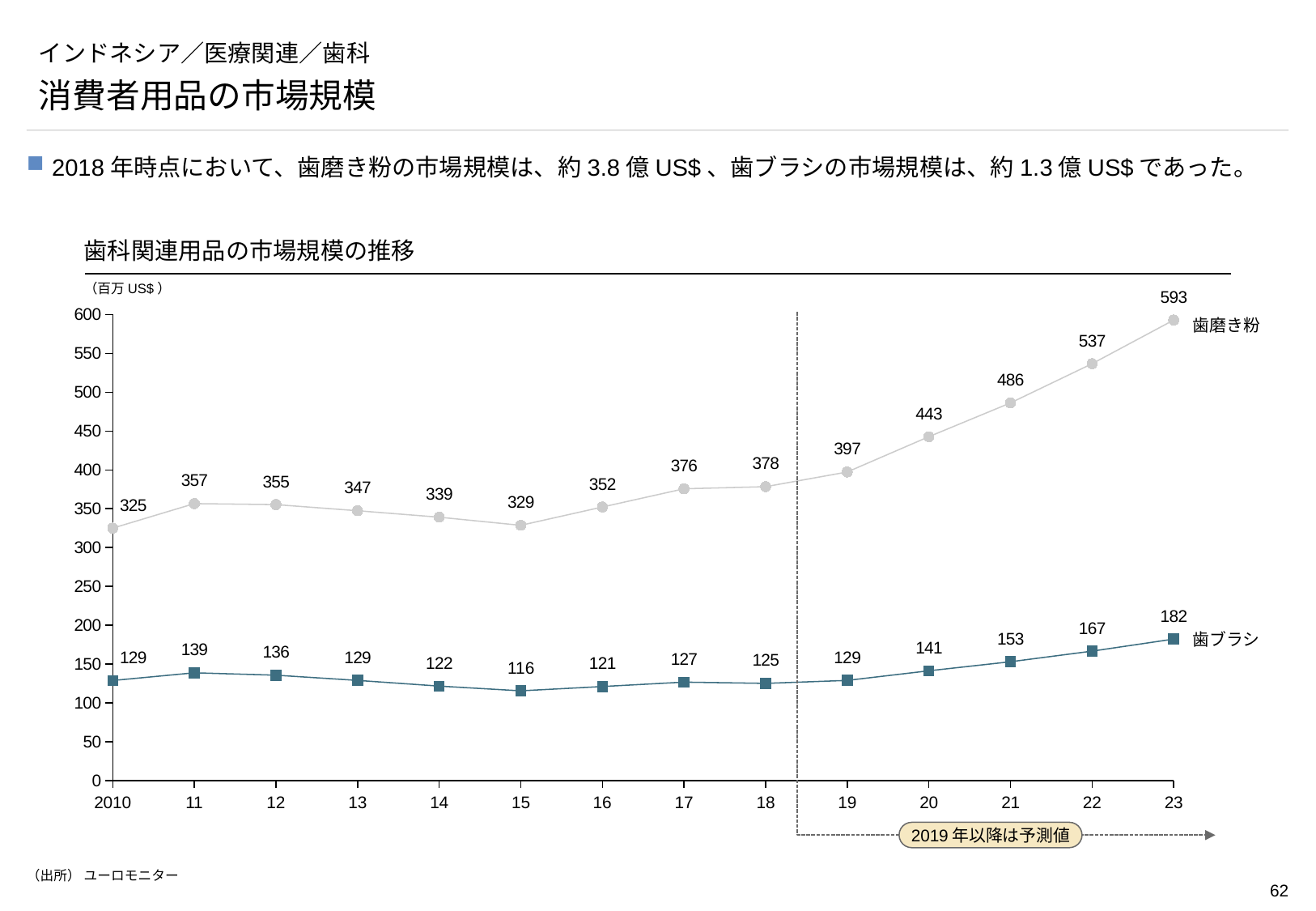
What is the value for 歯磨き粉 in 2018? 378 In which year is the 歯ブラシ series at its highest? 23 How many years are plotted on the x axis? 14 How many series are plotted on the chart? 2 What is the value for 歯ブラシ in 2015? 116 Is the value for 歯磨き粉 in 20 greater or less than 400? greater What is the difference between the 歯磨き粉 value in 23 and in 2010? 268 Which is larger, the 歯ブラシ value in 11 or in 12? 11 What is the unit shown for the chart's values? 百万 US$ In which year is the 歯磨き粉 series at its lowest? 2010 Does the 歯磨き粉 series rise or fall from 18 to 23? rise What kind of chart is shown? line chart